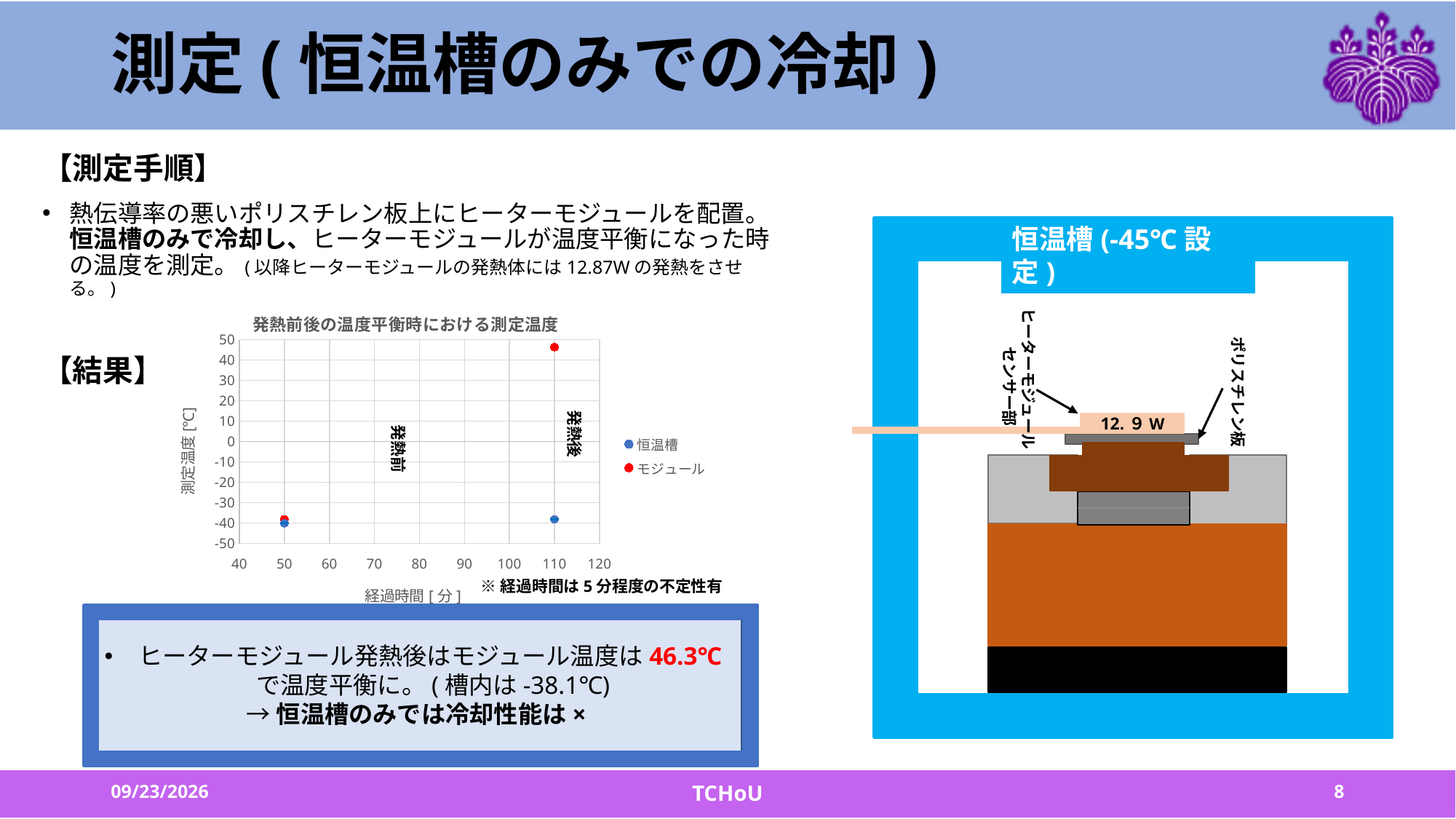
What kind of chart is shown on the slide? scatter chart What is the モジュール temperature at equilibrium after heating (発熱後), as stated on the slide? 46.3℃ What are the two series named in the chart legend? 恒温槽 and モジュール What is the 恒温槽 temperature at equilibrium after heating (発熱後), as stated on the slide? -38.1℃ Is the モジュール value at 50 minutes (発熱前) greater or less than 0? less At 110 minutes (発熱後), which series has the higher temperature, モジュール or 恒温槽? モジュール Is the モジュール value at 110 minutes (発熱後) greater or less than 40? greater Does the モジュール temperature rise or fall from 50 minutes to 110 minutes? rise What is the difference between the モジュール temperature (46.3℃) and the 恒温槽 temperature (-38.1℃) after heating? 84.4℃ Is the 恒温槽 value at 110 minutes (発熱後) greater or less than -30? less What is the title of the chart? 発熱前後の温度平衡時における測定温度 How many series does the chart legend list? 2